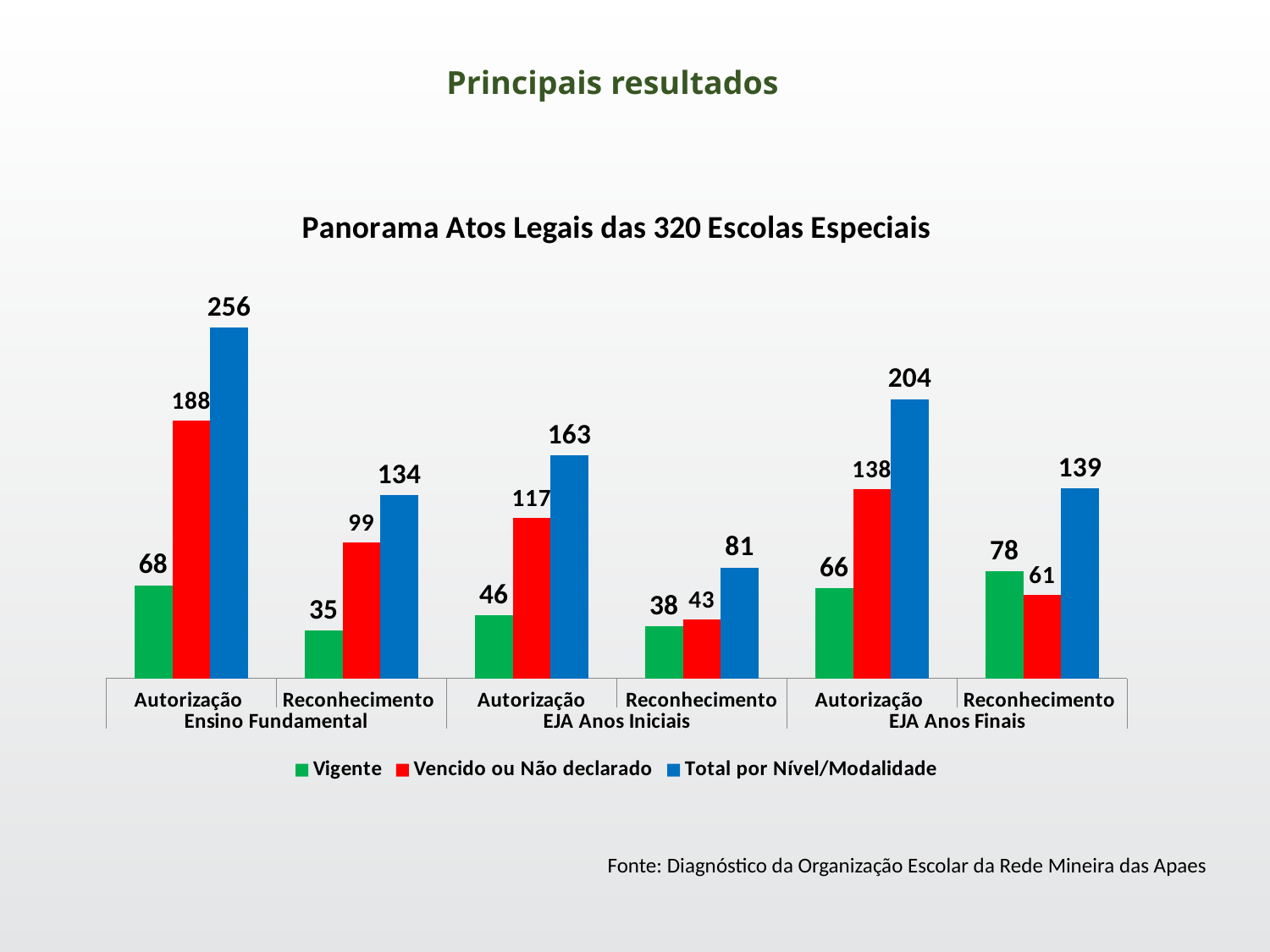
How many categories are shown on the x axis? 6 What is the value of 'Vencido ou Não declarado' for Reconhecimento under EJA Anos Iniciais? 43 What is the title of the chart? Panorama Atos Legais das 320 Escolas Especiais Which category has the lowest 'Vigente' value? Reconhecimento (Ensino Fundamental) Which is larger for Reconhecimento under EJA Anos Finais: 'Vigente' or 'Vencido ou Não declarado'? Vigente How many series does the legend list? 3 What kind of chart is shown on the slide? Bar chart What is the difference between 'Vencido ou Não declarado' and 'Vigente' for Autorização under Ensino Fundamental? 120 What is the value of 'Total por Nível/Modalidade' for Autorização under EJA Anos Finais? 204 Which category has the highest 'Total por Nível/Modalidade' value? Autorização (Ensino Fundamental) What is the value of 'Vigente' for Autorização under Ensino Fundamental? 68 What colour represents the 'Total por Nível/Modalidade' series? Blue